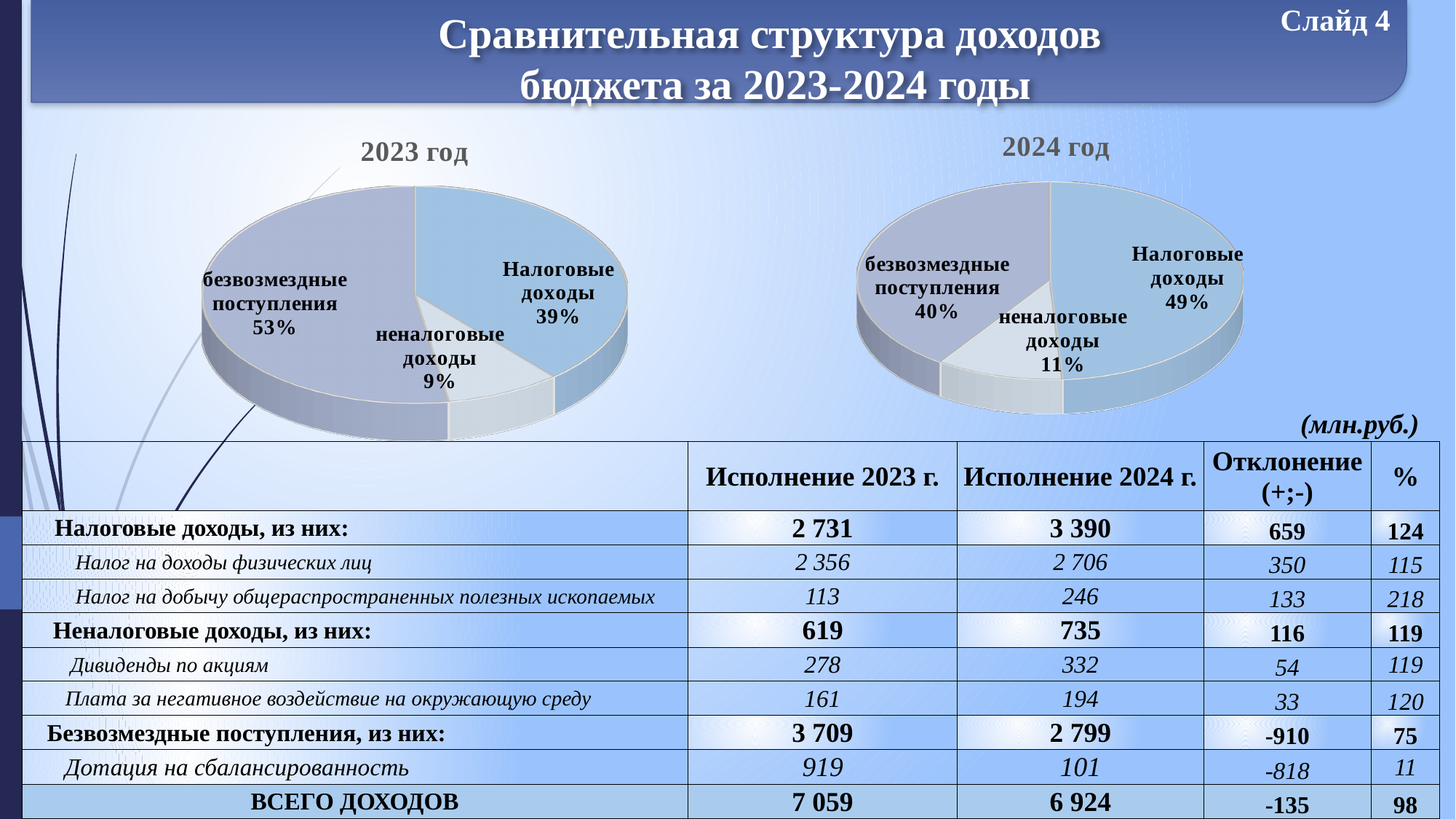
In the "2023 год" pie chart, which slice is the largest? безвозмездные поступления How many slices does the "2023 год" pie chart have? 3 In the "2024 год" pie chart, which slice is the smallest? неналоговые доходы In the "2023 год" pie chart, what share do "Налоговые доходы" have? 39% What kind of chart is the "2023 год" chart? pie chart In the "2024 год" pie chart, what share do "Налоговые доходы" have? 49% In the "2023 год" pie chart, what share do "безвозмездные поступления" have? 53% What is the difference in percentage points between the "безвозмездные поступления" share in the "2023 год" chart and in the "2024 год" chart? 13 In the "2024 год" pie chart, which is larger: "Налоговые доходы" or "безвозмездные поступления"? Налоговые доходы